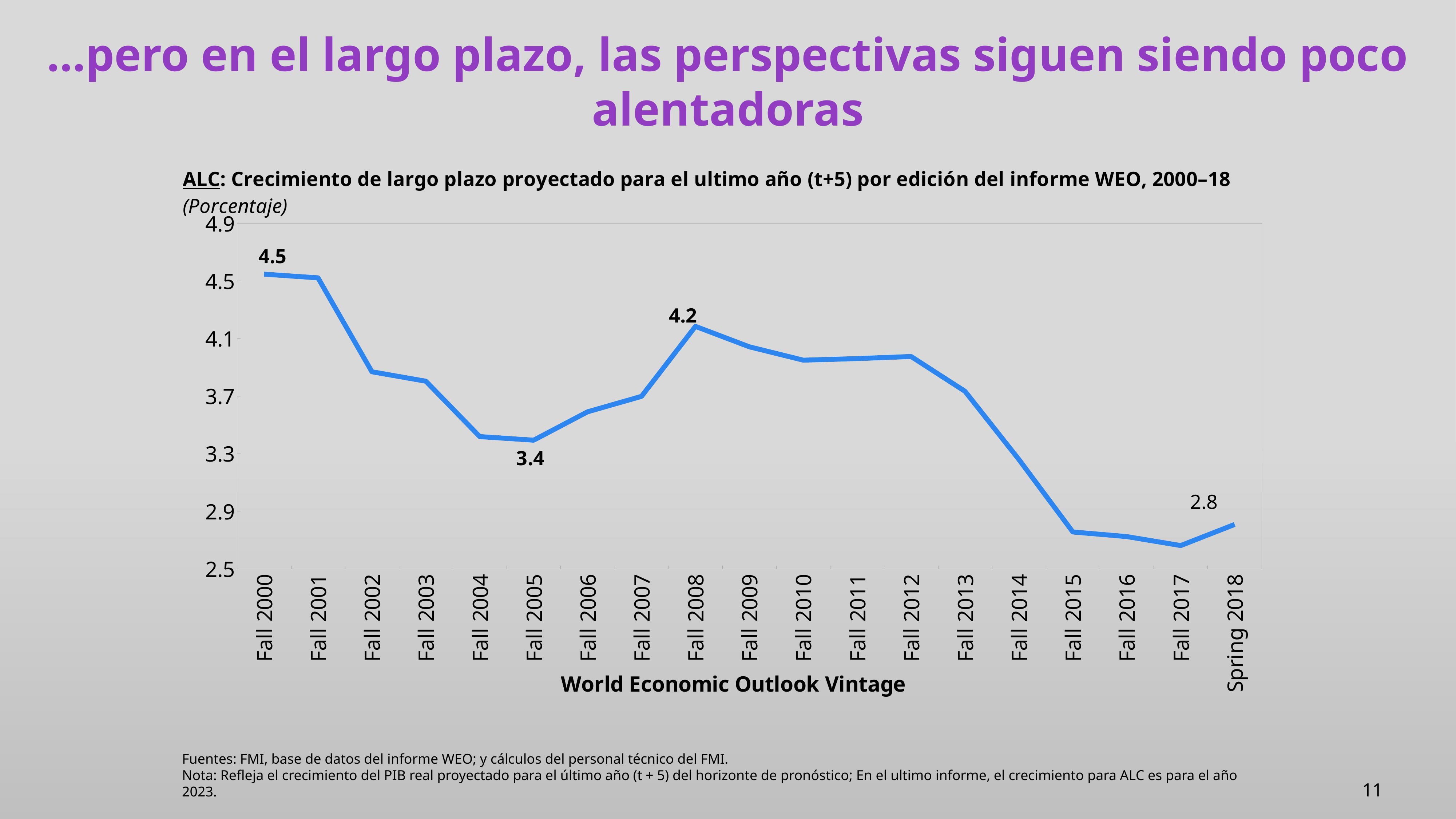
Is the value for Fall 2012 greater or less than 3.7? greater How many WEO vintages are plotted on the x axis? 19 Overall, do the values rise or fall from Fall 2000 to Spring 2018? fall What kind of chart is shown on the slide? line chart Which is larger, the value for Fall 2008 or the value for Fall 2005? Fall 2008 What is the difference between the Fall 2000 value and the Spring 2018 value? 1.7 Is the value for Fall 2015 greater or less than 2.9? less What is the difference between the Fall 2008 value and the Fall 2005 value? 0.8 What value is labelled for Fall 2005? 3.4 What value is labelled for Fall 2008? 4.2 What is the projected long-term growth value for Fall 2000? 4.5 What is the value shown for Spring 2018? 2.8